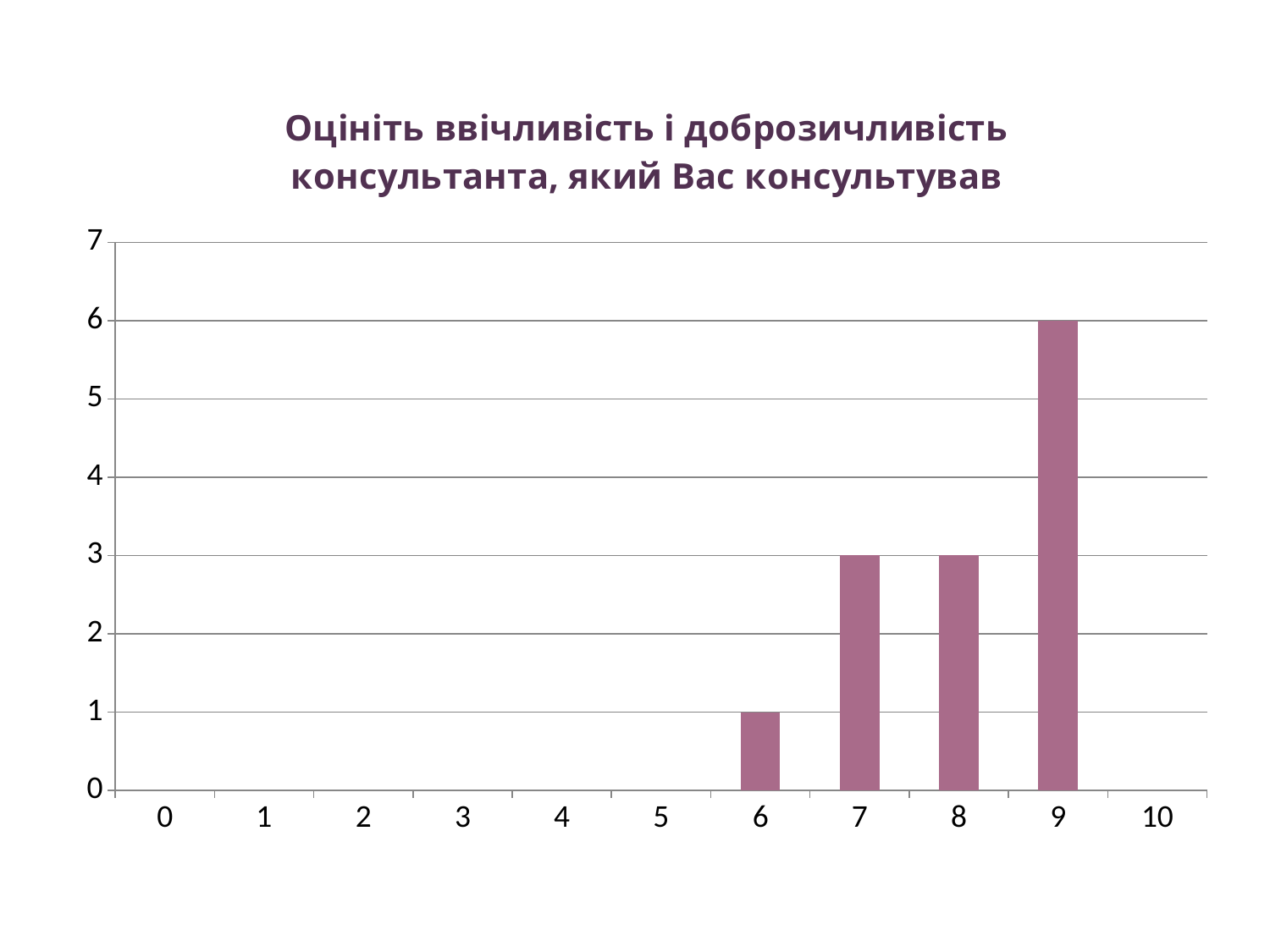
What is the value for category 8? 3 Which is larger, the value for category 9 or the value for category 8? 9 What is the title of the chart? Оцініть ввічливість і доброзичливість консультанта, який Вас консультував How many categories are shown on the x axis? 11 Is the value for category 9 greater or less than 5? greater What is the value for category 9? 6 Which category has the highest value? 9 What is the difference between the values for category 9 and category 7? 3 What kind of chart is shown on the slide? bar chart What is the value for category 6? 1 Do the values rise or fall from category 6 to category 9? rise What is the value for category 7? 3